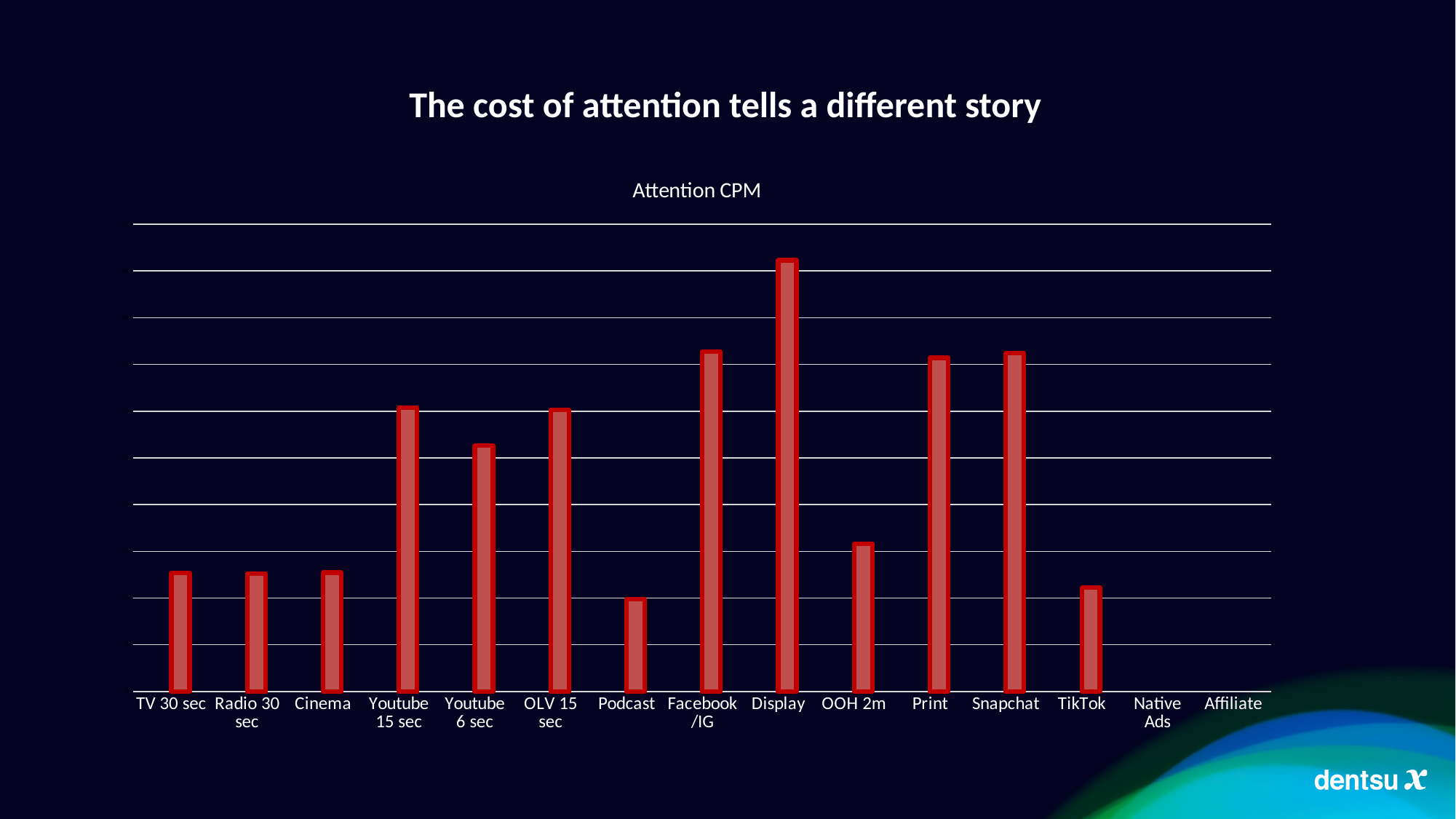
Which two categories on the x axis have no visible bar? Native Ads and Affiliate Which has a higher Attention CPM, OOH 2m or TikTok? OOH 2m Which has a higher Attention CPM, Display or Facebook/IG? Display Which has a higher Attention CPM, Youtube 15 sec or Youtube 6 sec? Youtube 15 sec Among the categories with a visible bar, which has the lowest Attention CPM? Podcast Which category has the highest Attention CPM? Display What is the title of the chart? Attention CPM What kind of chart is shown on the slide? Bar chart How many categories are listed along the x axis of the chart? 15